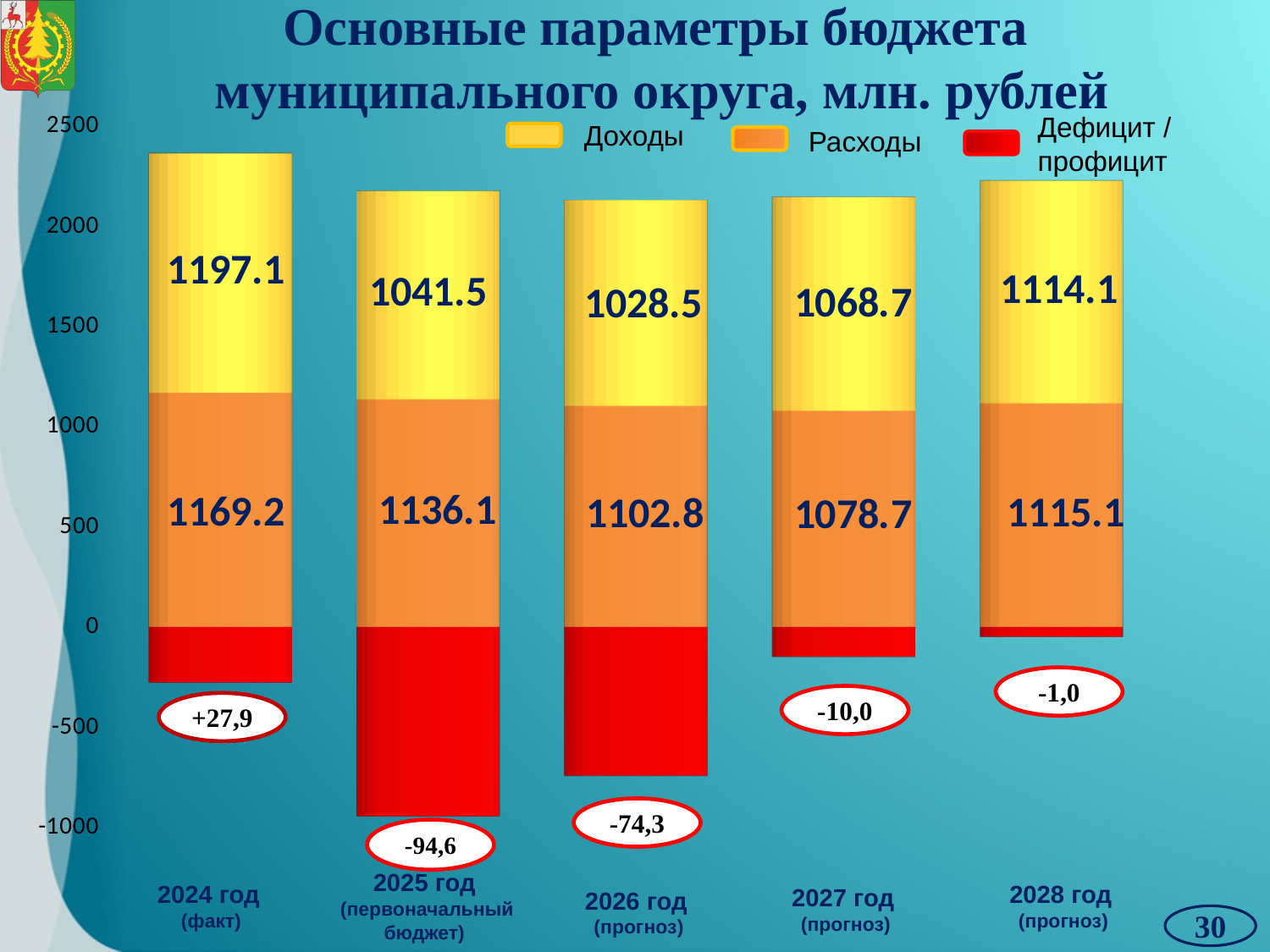
What is the value of Доходы for 2028 год (прогноз)? 1114.1 What is the difference between Доходы in 2024 год (факт) and Доходы in 2025 год (первоначальный бюджет)? 155.6 What kind of chart is shown on the slide? Stacked bar chart What is the value of Доходы for 2024 год (факт)? 1197.1 How many years (categories) are shown on the x axis? 5 Which is larger in 2026 год (прогноз): Доходы or Расходы? Расходы Which year has the lowest value of Расходы? 2027 год (прогноз) What is the Дефицит / профицит value shown for 2025 год (первоначальный бюджет)? -94,6 What is the value of Расходы for 2026 год (прогноз)? 1102.8 How many series does the legend list? 3 Which series is shown in red in the legend? Дефицит / профицит Which year has the highest value of Доходы? 2024 год (факт)